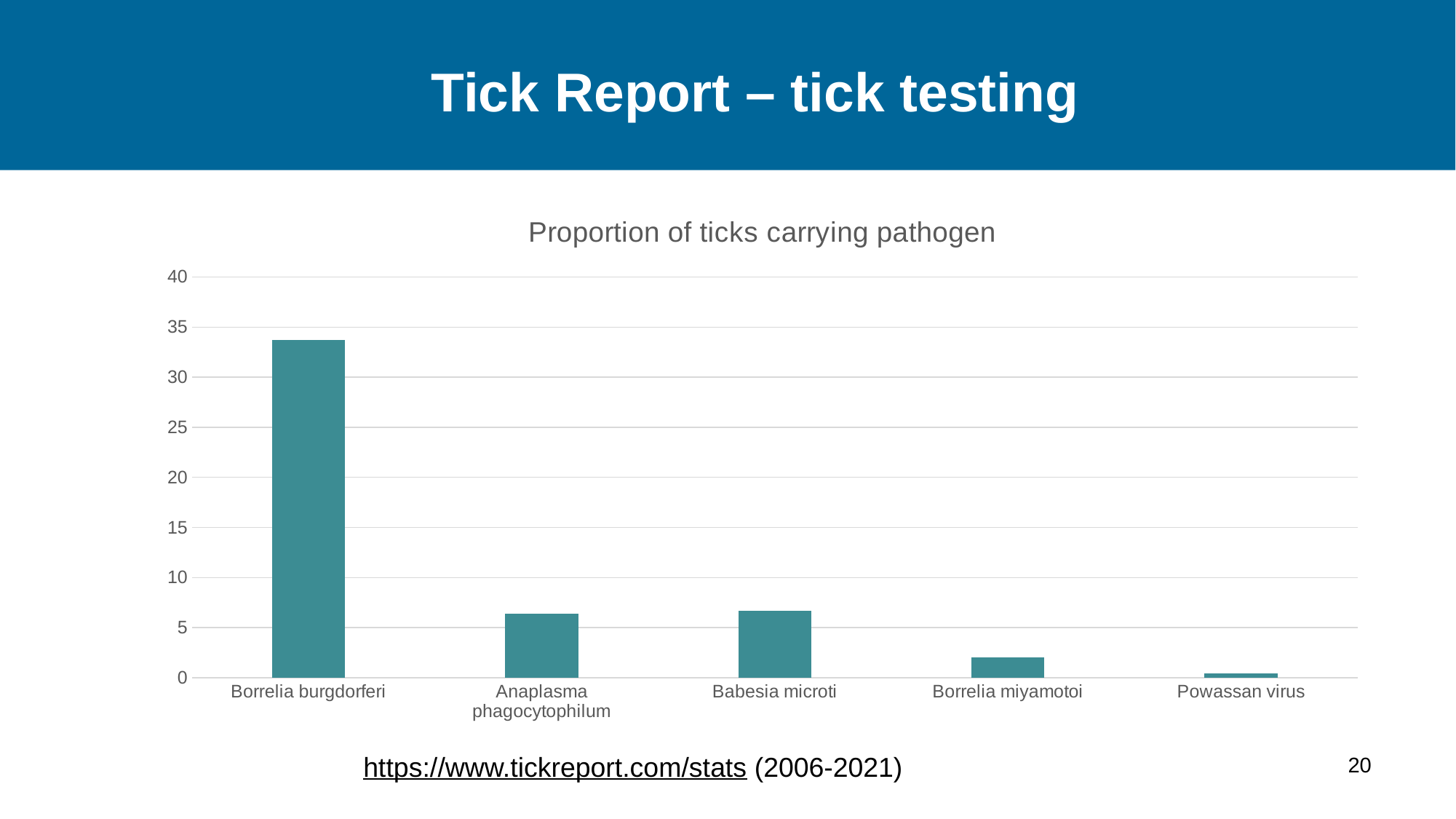
Is the value for Borrelia burgdorferi greater or less than 35? less Is the value for Borrelia burgdorferi greater or less than 30? greater Is the value for Borrelia miyamotoi greater or less than 5? less What is the title of the chart? Proportion of ticks carrying pathogen Which is larger, the value for Borrelia miyamotoi or the value for Powassan virus? Borrelia miyamotoi Which pathogen has the highest proportion of ticks carrying it? Borrelia burgdorferi Which is larger, the value for Borrelia burgdorferi or the value for Babesia microti? Borrelia burgdorferi What kind of chart is shown on the slide? bar chart How many pathogens are shown on the x axis of the chart? 5 Which pathogen has the lowest proportion of ticks carrying it? Powassan virus